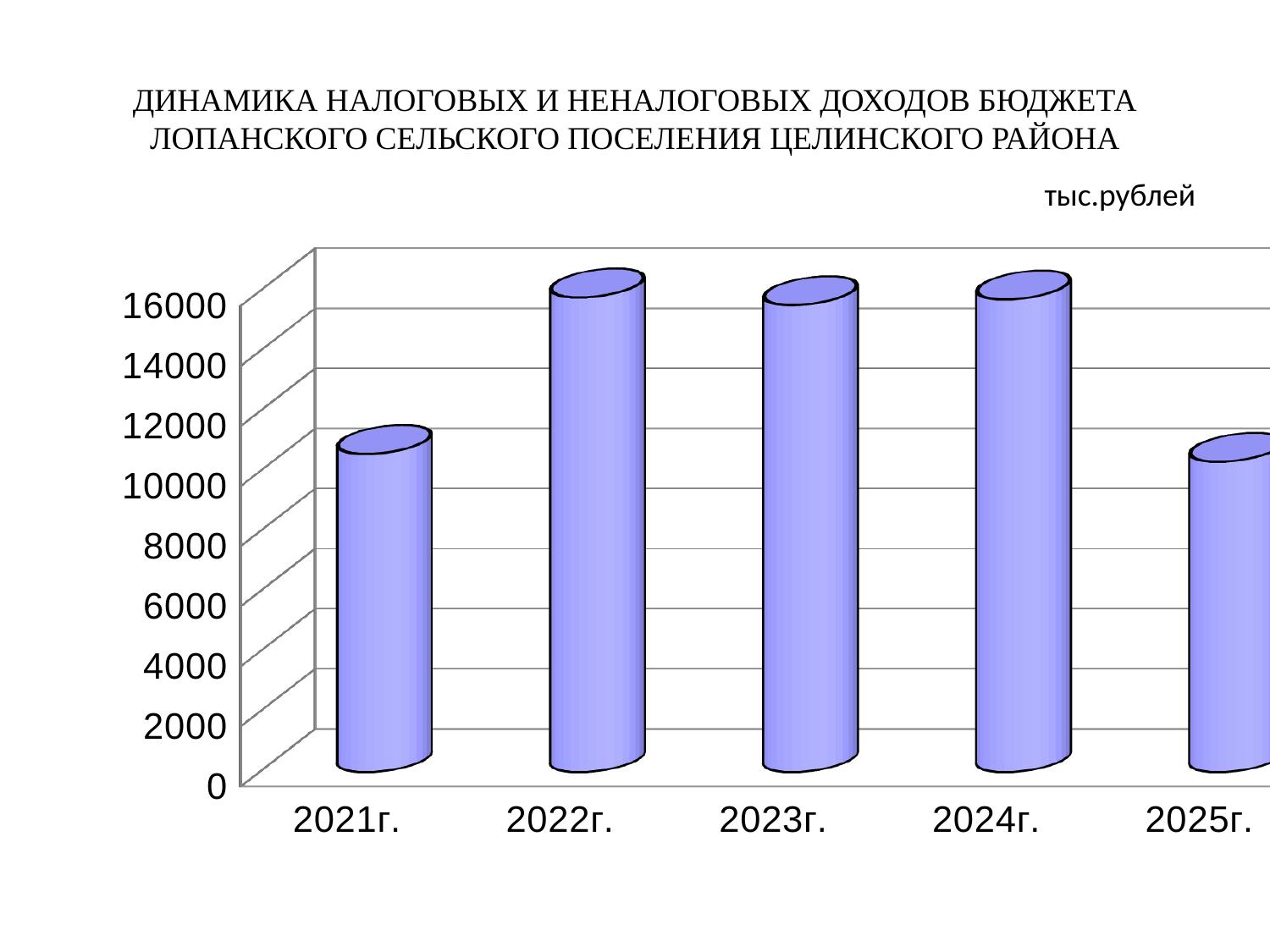
In what units are the values on the chart expressed, according to the label above the chart? тыс.рублей Does the value rise or fall from 2024г. to 2025г.? fall Is the value for 2022г. greater or less than 14000? greater Is the value for 2023г. greater or less than 12000? greater Does the value rise or fall from 2021г. to 2022г.? rise Which is larger, the value for 2024г. or the value for 2025г.? 2024г. What kind of chart is shown on the slide? bar chart How many years are shown on the x axis of the chart? 5 Is the value for 2025г. greater or less than 14000? less Which is larger, the value for 2021г. or the value for 2022г.? 2022г.